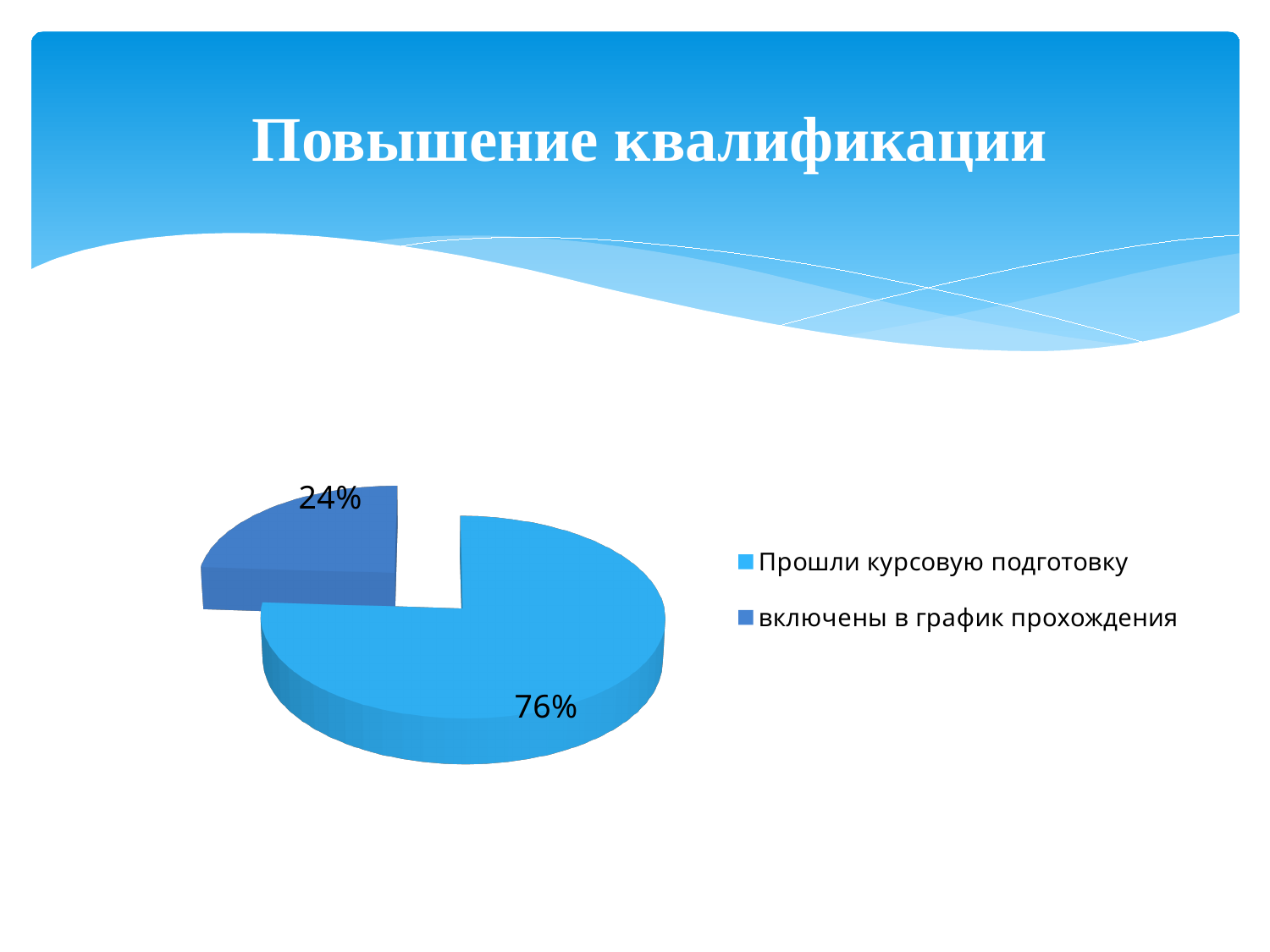
Which category has the largest slice of the pie? Прошли курсовую подготовку What kind of chart is shown on the slide? Pie chart Which legend entry is shown in the darker blue colour? включены в график прохождения What is the difference in percentage points between the "Прошли курсовую подготовку" slice and the "включены в график прохождения" slice? 52 Which is larger: the slice for "Прошли курсовую подготовку" or the slice for "включены в график прохождения"? Прошли курсовую подготовку How many slices does the pie chart have? 2 What is the title of the slide containing the pie chart? Повышение квалификации What share of the pie is labelled "включены в график прохождения"? 24% How many entries does the legend list? 2 What share of the pie is labelled "Прошли курсовую подготовку"? 76% Which category has the smallest slice of the pie? включены в график прохождения